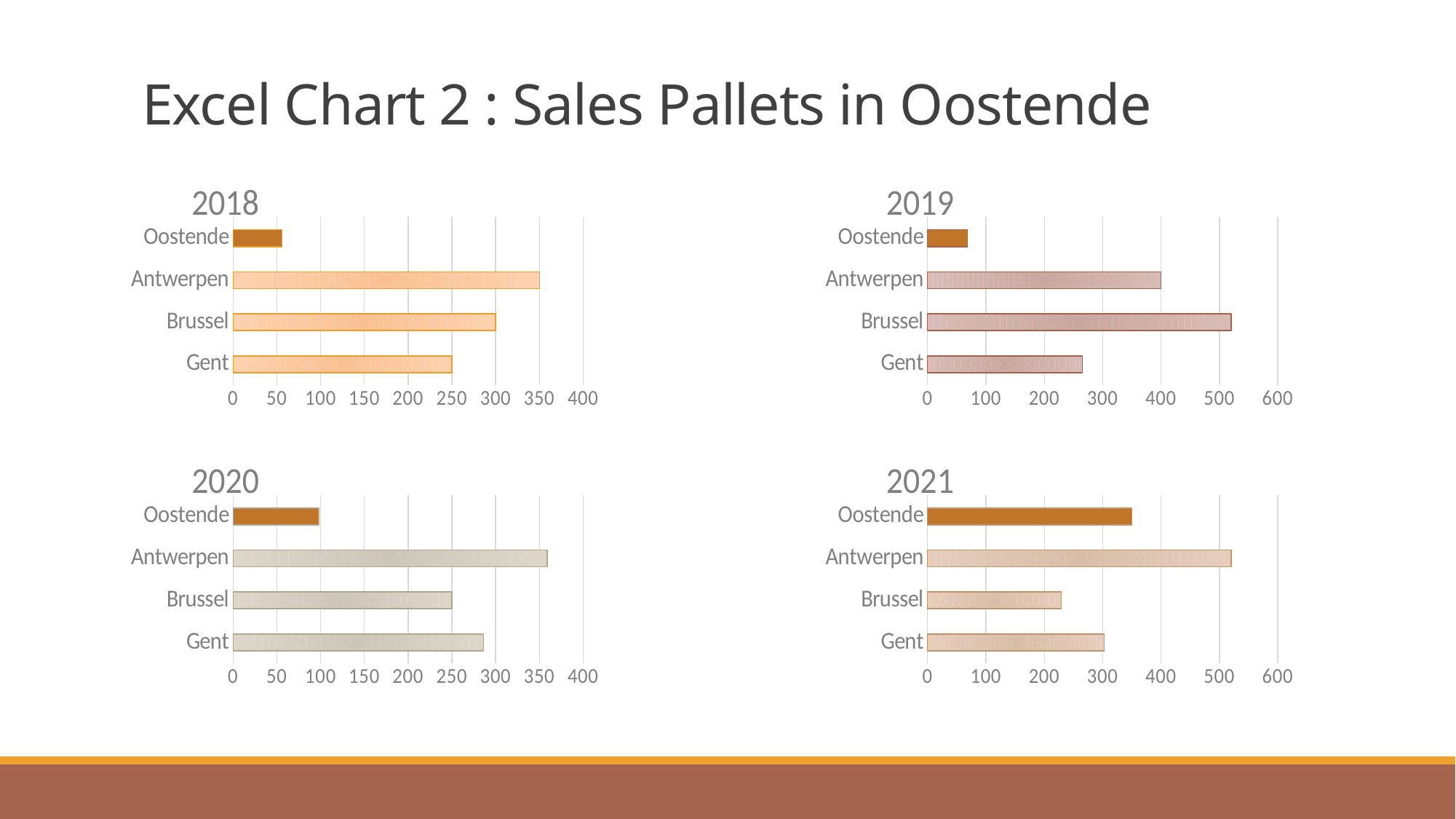
In the 2019 chart, is the value for Brussel greater or less than 500? greater In the 2021 chart, which category has the lowest value? Brussel In the 2018 chart, which category has the lowest value? Oostende How many charts are shown on the slide? 4 What kind of chart is the 2018 chart? bar chart In the 2018 chart, is the value for Oostende greater or less than 100? less In the 2021 chart, which is larger, the value for Oostende or the value for Brussel? Oostende In the 2019 chart, which category has the highest value? Brussel In the 2020 chart, which category has the highest value? Antwerpen In the 2018 chart, what is the value for Brussel? 300 In the 2018 chart, how many categories are shown? 4 In the 2018 chart, which category has the highest value? Antwerpen